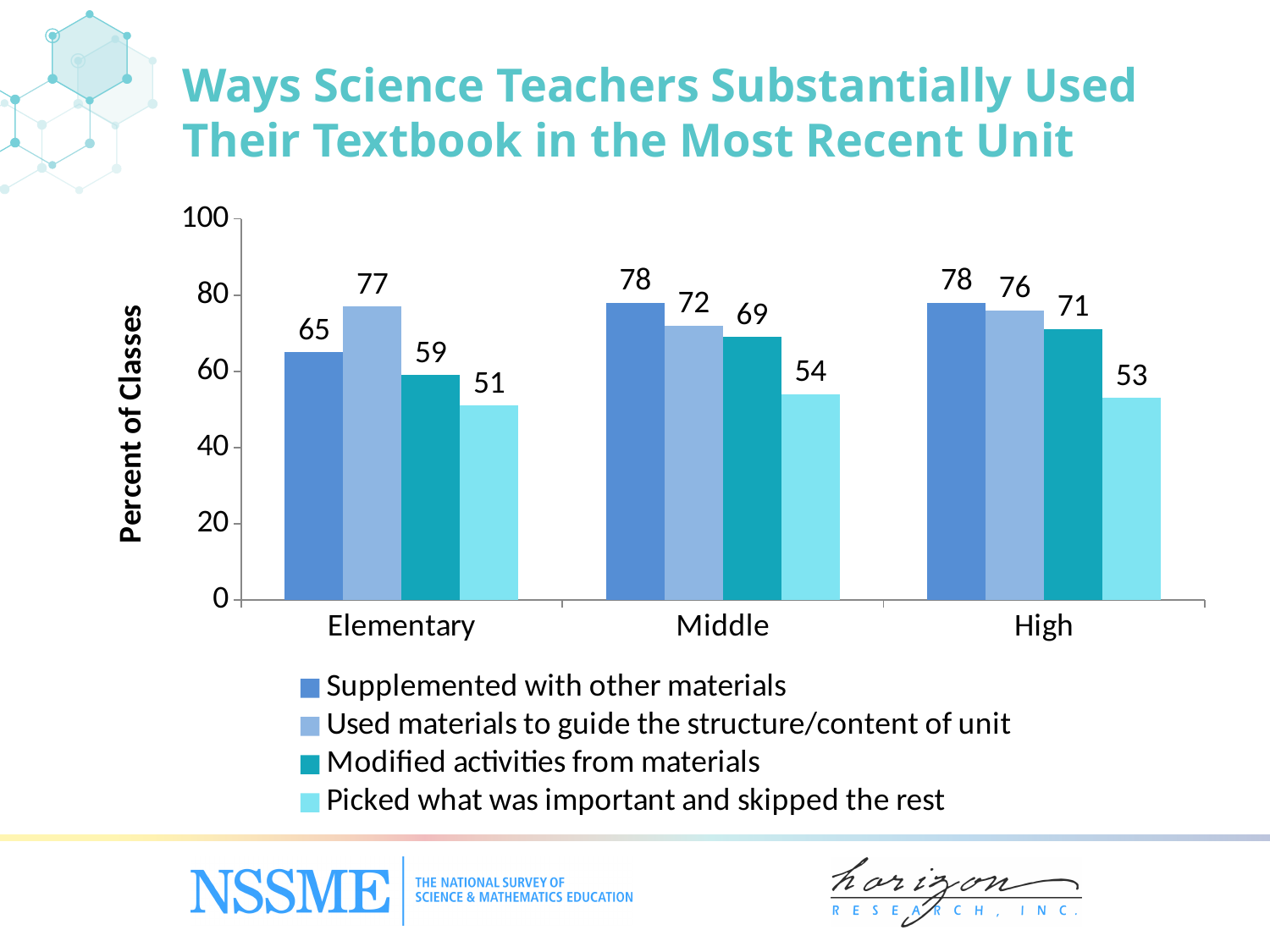
What is the difference between 'Supplemented with other materials' and 'Picked what was important and skipped the rest' for Middle classes? 24 What is the label of the y axis? Percent of Classes What kind of chart is shown on the slide? Bar chart Which series has the lowest value for High classes? Picked what was important and skipped the rest Is the value for 'Modified activities from materials' in Elementary classes greater or less than 60? less What is the value for 'Modified activities from materials' in High classes? 71 How many series does the legend list? 4 What is the value for 'Picked what was important and skipped the rest' in Middle classes? 54 Which is larger for Elementary classes: 'Supplemented with other materials' or 'Used materials to guide the structure/content of unit'? Used materials to guide the structure/content of unit What is the value for 'Supplemented with other materials' in Elementary classes? 65 How many grade-level categories are shown on the x axis? 3 Which series has the highest value for Elementary classes? Used materials to guide the structure/content of unit